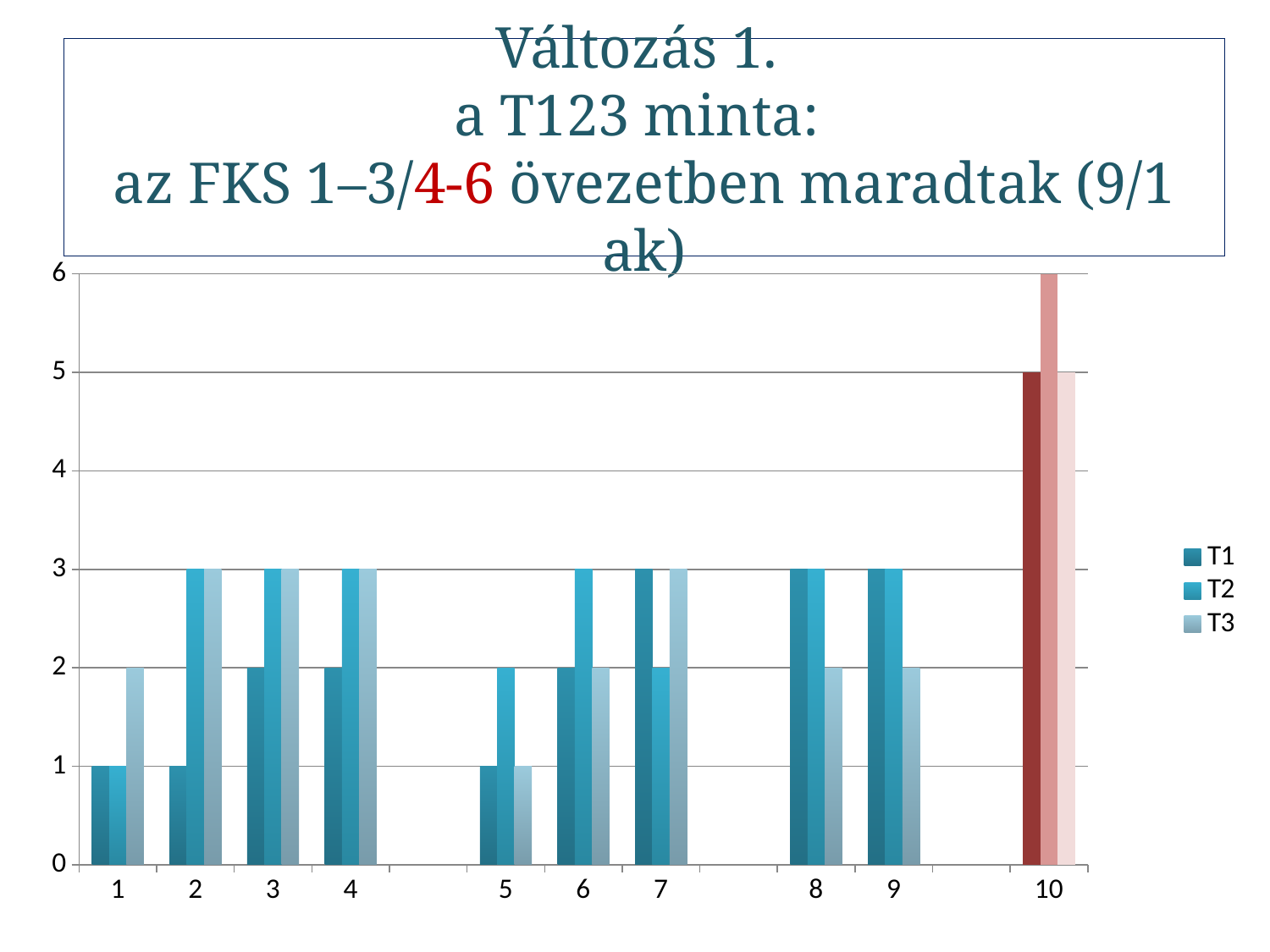
Which is larger for category 7, the T1 value or the T2 value? T1 What is the value of T3 for category 1? 2 Is the value of T2 for category 10 greater or less than 5? greater What is the value of T1 for category 5? 1 What is the value of T1 for category 10? 5 What is the value of T2 for category 10? 6 Which category has the highest T2 value? 10 What type of chart is shown on the slide? bar chart How many series does the legend list? 3 What is the difference between the T2 value and the T1 value for category 10? 1 Which series is shown in the lightest colour in the legend? T3 How many categories are shown on the x axis? 10